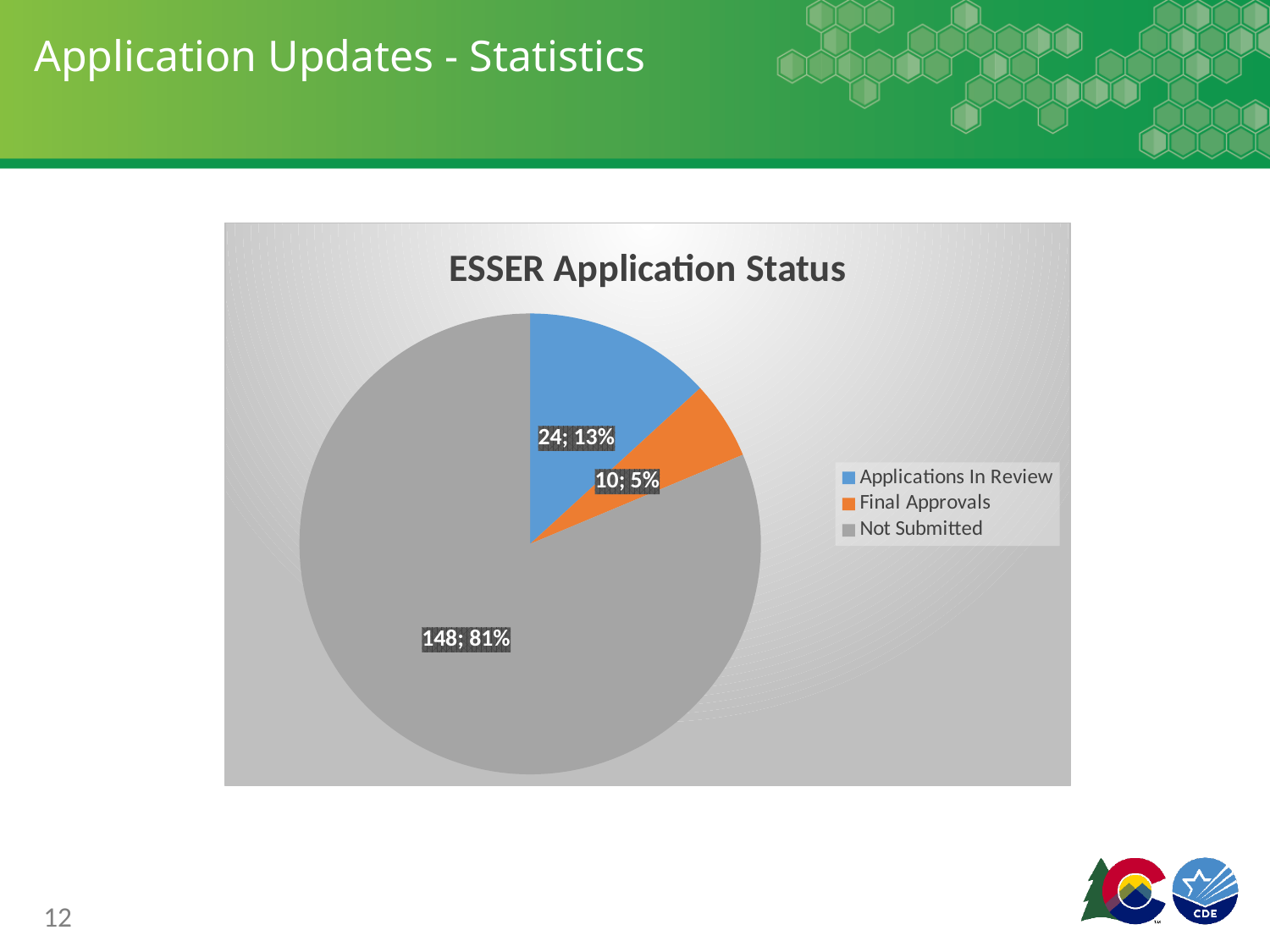
How many entries does the legend list? 3 What is the title of the chart? ESSER Application Status What share of the pie is Applications In Review? 13% What is the count for Final Approvals? 10 What is the count for Applications In Review? 24 What kind of chart is shown on the slide? pie chart What is the count for Not Submitted? 148 What share of the pie is Not Submitted? 81% Which category has the smallest slice? Final Approvals What is the difference between the Not Submitted count and the Applications In Review count? 124 Which category has the largest slice? Not Submitted How many categories does the pie chart have? 3